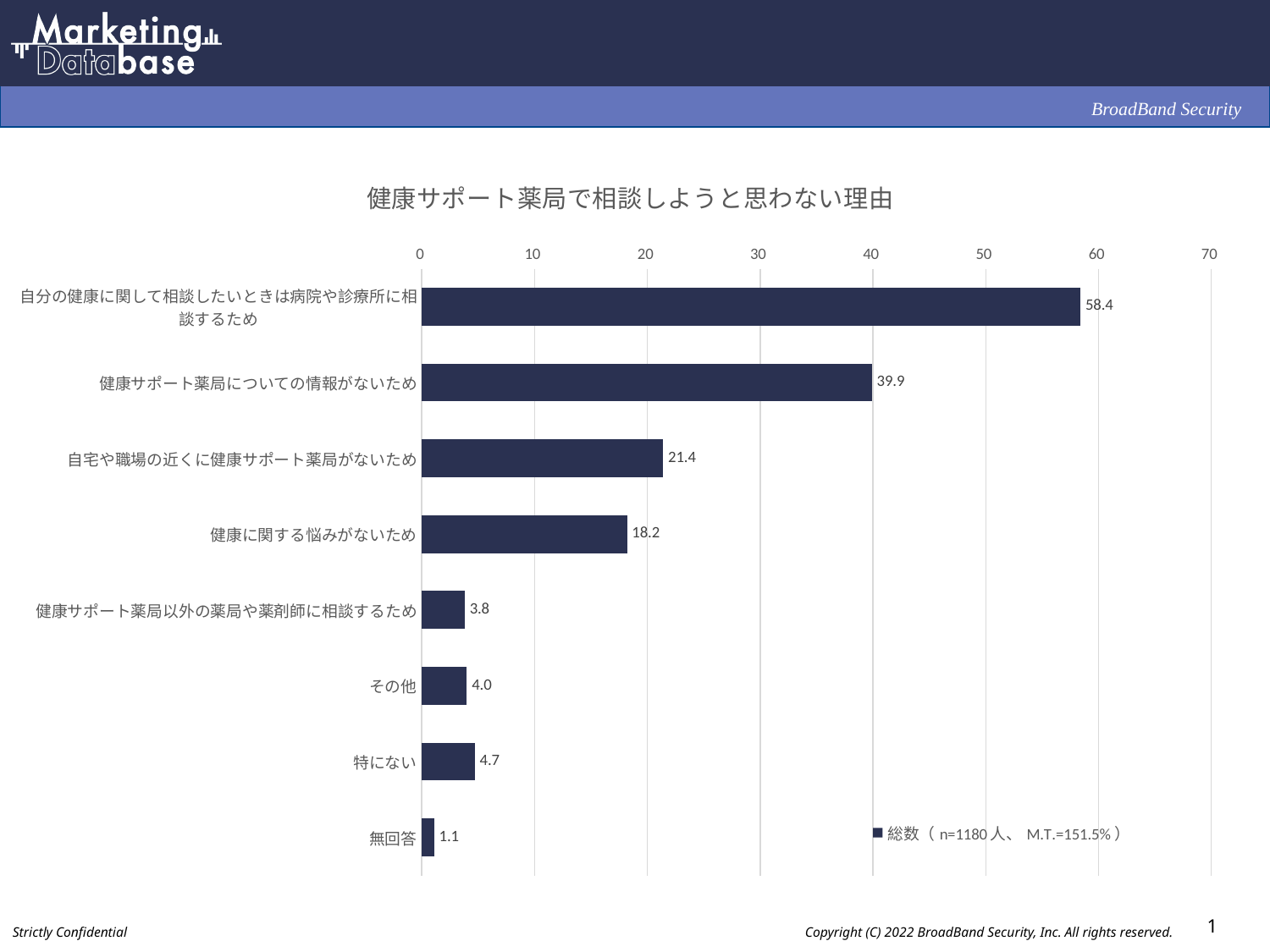
Which is larger: the value for 自宅や職場の近くに健康サポート薬局がないため or 健康に関する悩みがないため? 自宅や職場の近くに健康サポート薬局がないため Which category has the highest value? 自分の健康に関して相談したいときは病院や診療所に相談するため How many series does the legend list? 1 What is the value for 健康サポート薬局についての情報がないため? 39.9 Is the value for 健康サポート薬局についての情報がないため greater or less than 30? greater What is the value for 健康に関する悩みがないため? 18.2 What is the title of the chart? 健康サポート薬局で相談しようと思わない理由 What is the difference between the values for 自分の健康に関して相談したいときは病院や診療所に相談するため and 健康サポート薬局についての情報がないため? 18.5 What is the value for 特にない? 4.7 What kind of chart is shown on the slide? Bar chart Which category has the lowest value? 無回答 How many categories are shown in the chart? 8